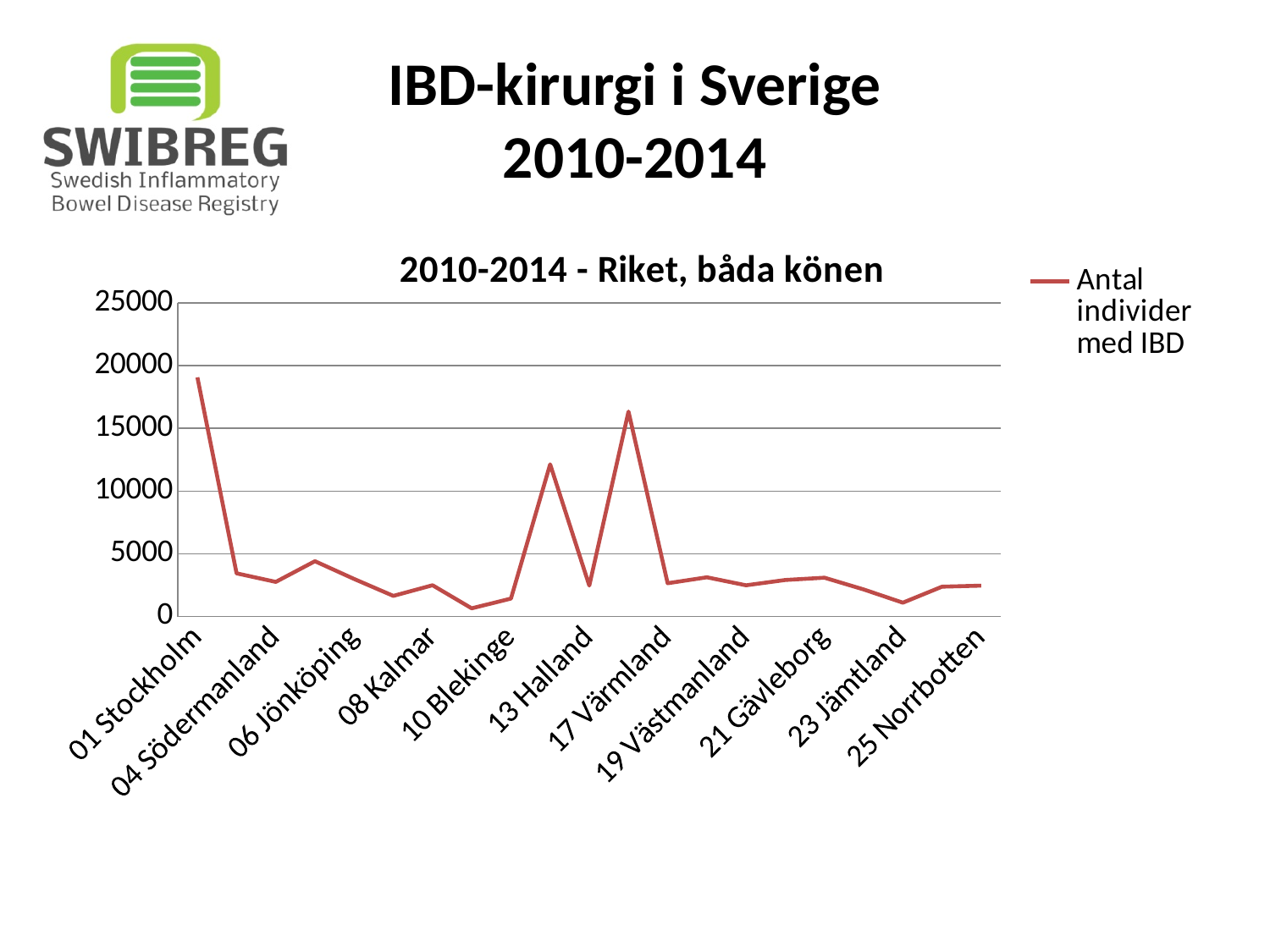
Is the value for 04 Södermanland greater or less than 5000? less Is the value for 23 Jämtland greater or less than 5000? less Which labelled category has the highest value? 01 Stockholm Which has the larger value, 06 Jönköping or 10 Blekinge? 06 Jönköping What is the name of the series shown in the legend? Antal individer med IBD What is the title of the chart? 2010-2014 - Riket, båda könen Is the value for 01 Stockholm greater or less than 15000? greater What kind of chart is shown on the slide? Line chart Does the line rise or fall from 01 Stockholm to 04 Södermanland? fall Which has the larger value, 01 Stockholm or 04 Södermanland? 01 Stockholm How many series does the chart legend list? 1